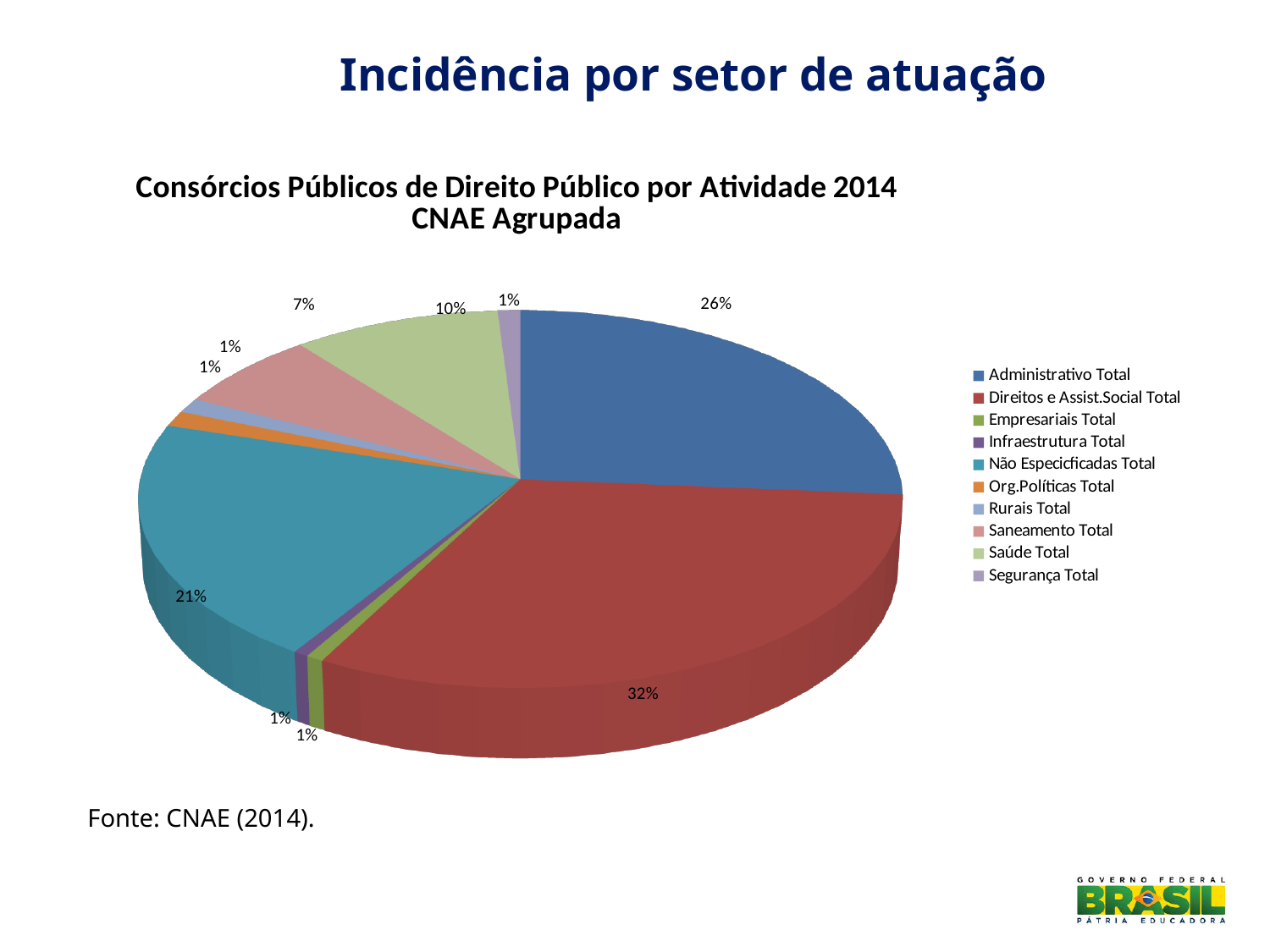
What is the value shown for Saneamento Total? 7% Which is larger, the share for Não Especificadas Total or the share for Saúde Total? Não Especificadas Total What share of the pie does Direitos e Assist.Social Total represent? 32% What is the title of the chart? Consórcios Públicos de Direito Público por Atividade 2014 CNAE Agrupada What is the value shown for Saúde Total? 10% What is the source cited below the chart? CNAE (2014) What kind of chart is shown on the slide? Pie chart What share of the pie does Administrativo Total represent? 26% Which category has the largest slice of the pie? Direitos e Assist.Social Total What is the value shown for Não Especificadas Total? 21% What is the difference between the shares of Direitos e Assist.Social Total and Administrativo Total? 6% How many categories does the legend list? 10